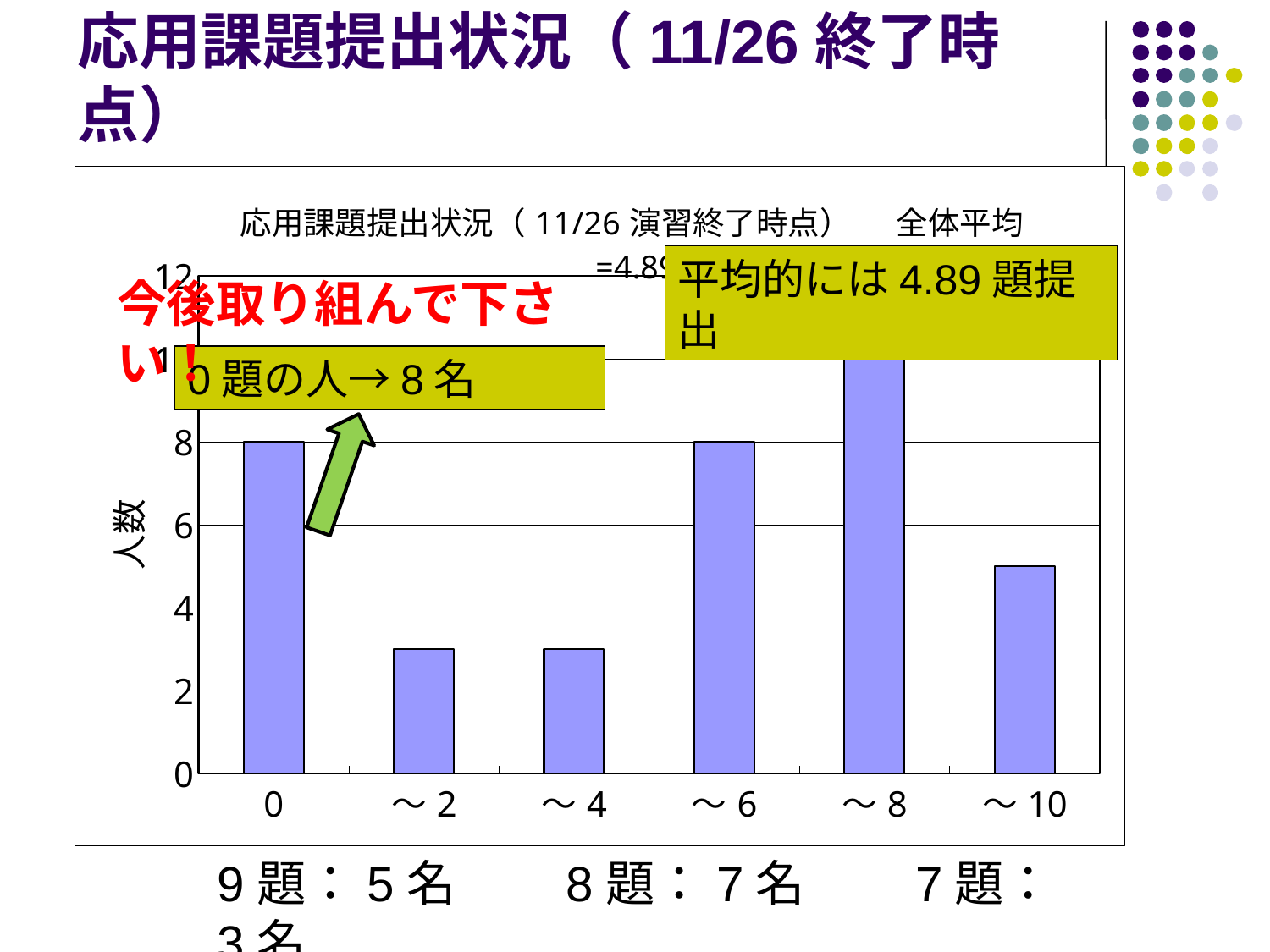
What is the label on the y axis of the chart? 人数 What is the value (人数) for the category 0? 8 According to the chart title, what is the overall average (全体平均) number of submitted problems? 4.89 Is the value for ～2 greater or less than 4? less What is the value (人数) for the category ～6? 8 How many categories are shown on the x axis of the chart? 6 Which category has the highest bar? ～8 Is the value for ～8 greater or less than 8? greater Which is larger, the value for ～10 or the value for ～4? ～10 Which is larger, the value for 0 or the value for ～2? 0 What kind of chart is shown on the slide? bar chart Is the value for ～10 greater or less than 4? greater